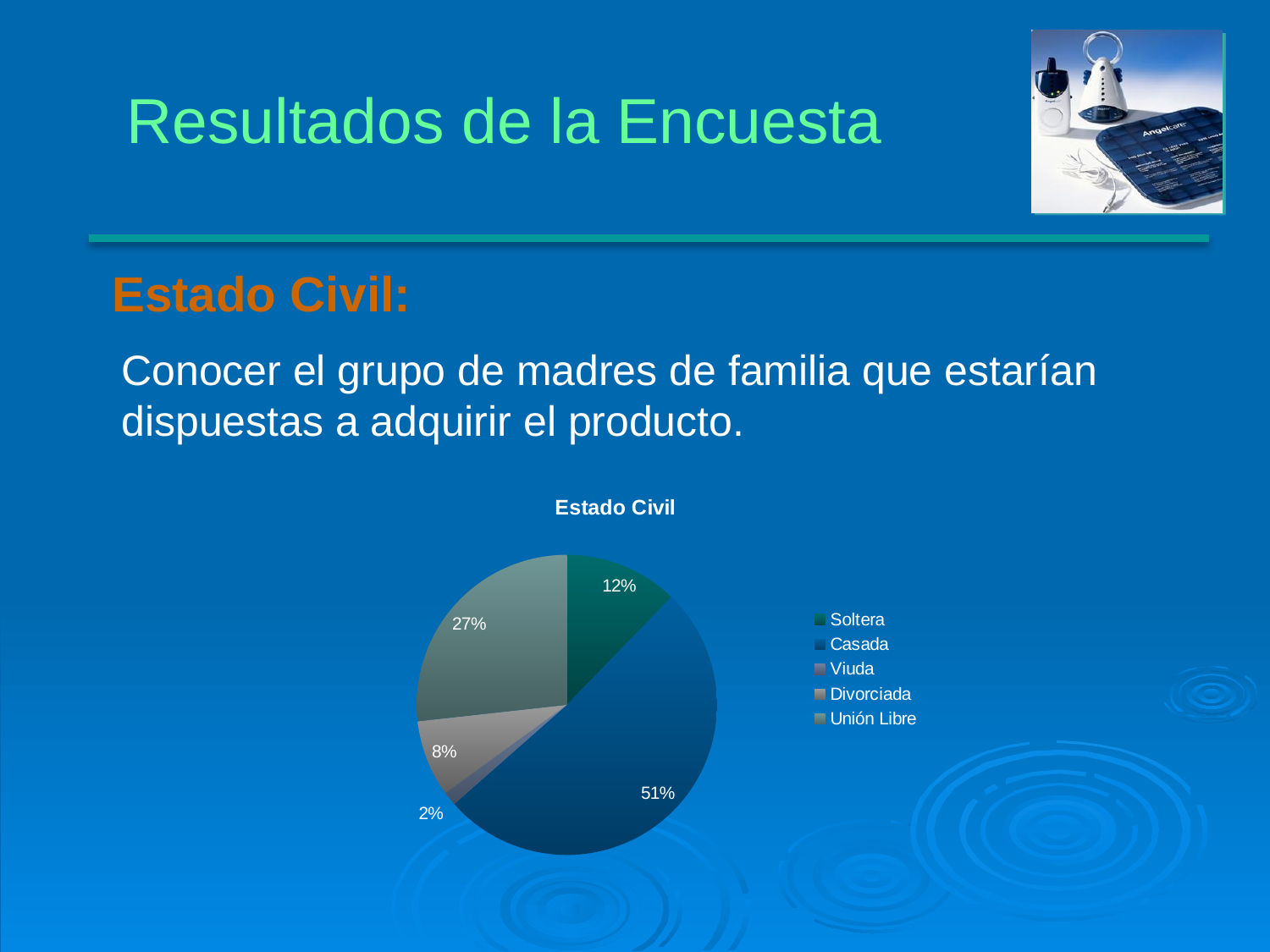
What is the difference in percentage points between Casada and Unión Libre? 24 How many categories does the legend of the pie chart list? 5 Which is larger, the share for Soltera or the share for Divorciada? Soltera What share of the pie does Casada represent? 51% What share of the pie does Divorciada represent? 8% What is the title of the chart? Estado Civil What share of the pie does Viuda represent? 2% Which category has the largest slice of the pie? Casada Which category has the smallest slice of the pie? Viuda What kind of chart is shown on the slide? pie chart